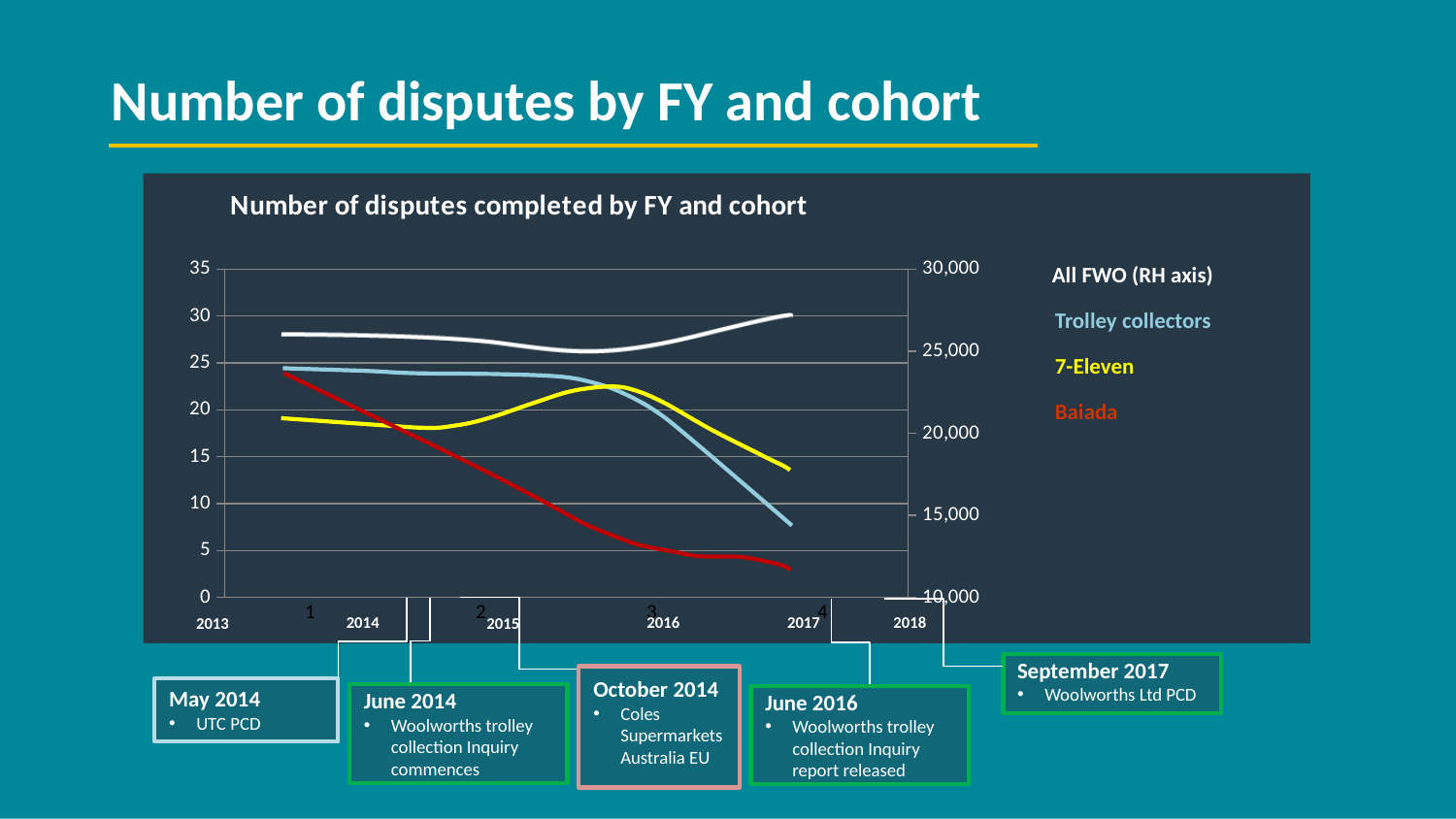
Is the value for Baiada in 2013 greater or less than 20? greater How many series does the chart's legend list? 4 In 2017, which is higher: Trolley collectors or 7-Eleven? 7-Eleven Is the value for All FWO in 2017 greater or less than 25,000 on the right-hand axis? greater Which series in the legend is plotted on the right-hand axis? All FWO What colour is the Baiada line? red Does the Trolley collectors line rise or fall from 2013 to 2017? fall In 2013, which is higher: Baiada or 7-Eleven? Baiada Is the value for Baiada in 2017 greater or less than 5? less What kind of chart is shown on the slide? line chart Does the Baiada line rise or fall from 2013 to 2017? fall